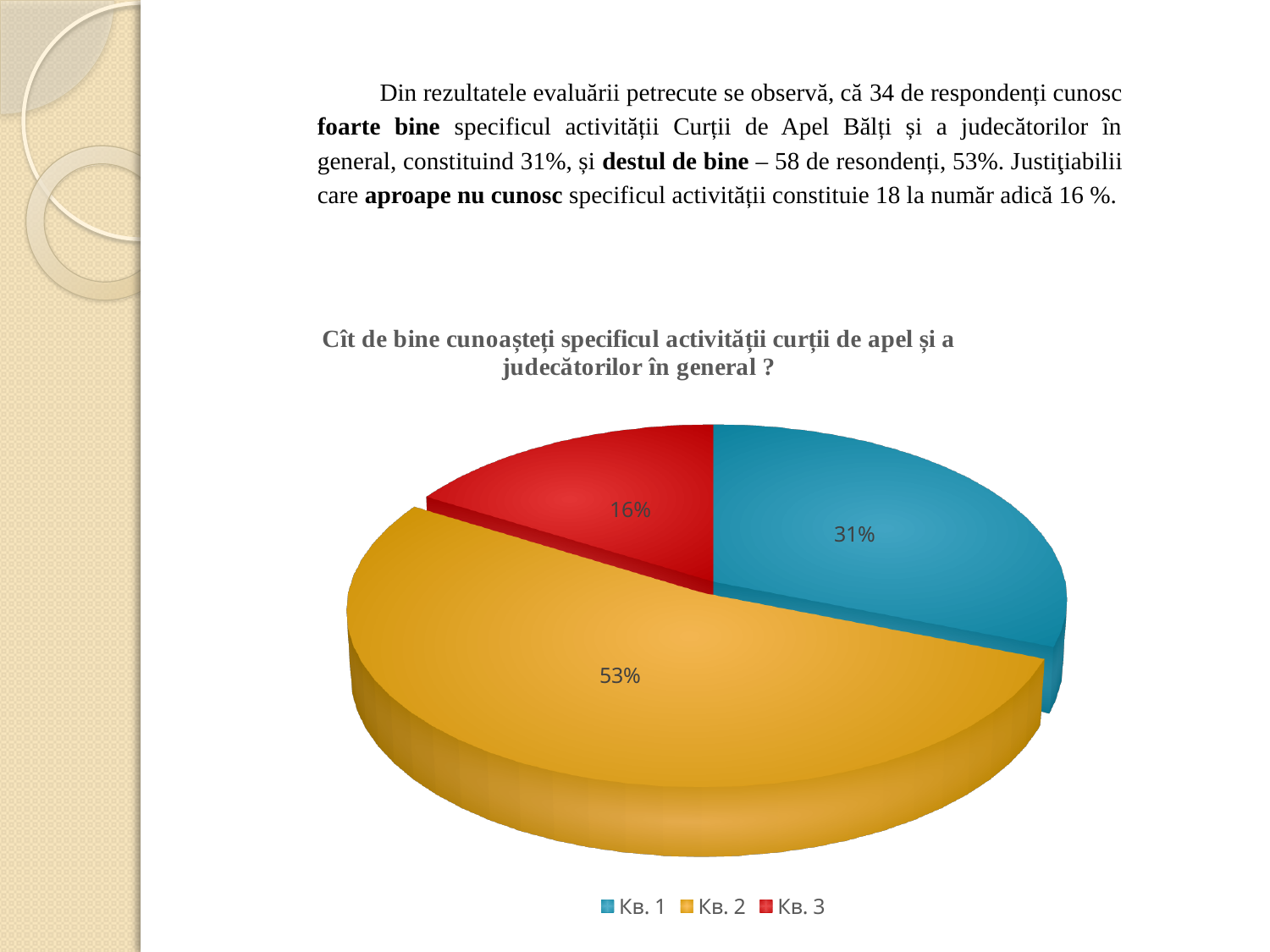
What percentage is shown for the Кв. 2 slice of the pie chart? 53% Which slice of the pie chart is the smallest? Кв. 3 Which slice of the pie chart is the largest? Кв. 2 Which is larger in the pie chart, the Кв. 1 slice or the Кв. 3 slice? Кв. 1 How many entries does the legend of the pie chart list? 3 What percentage is shown for the Кв. 1 slice of the pie chart? 31% What colour is the Кв. 2 slice in the pie chart? Yellow What percentage is shown for the Кв. 3 slice of the pie chart? 16% What kind of chart is shown on the slide? Pie chart What is the difference in percentage points between the Кв. 2 slice and the Кв. 1 slice? 22 What is the title of the pie chart? Cît de bine cunoașteți specificul activității curții de apel și a judecătorilor în general ? How many slices does the pie chart have? 3